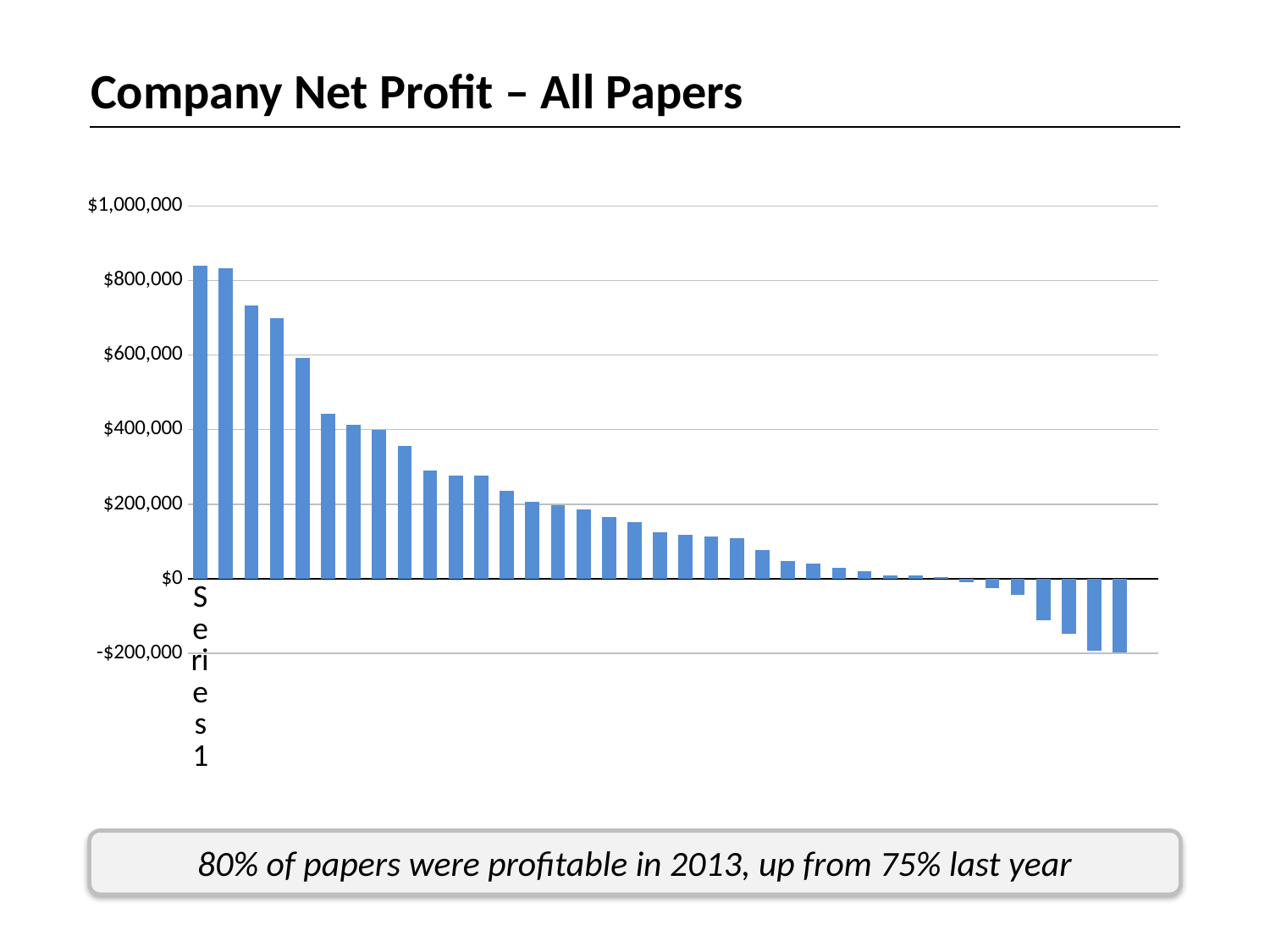
Do the bar values rise or fall from left to right across the chart? fall What kind of chart is shown on the slide? bar chart Is the value of the rightmost bar greater or less than $0? less Is the value of the third bar from the left greater or less than $600,000? greater Is the value of the leftmost bar greater or less than $800,000? greater Are any of the bars in the chart below $0? yes What is the title of the chart? Company Net Profit – All Papers What is the highest value shown on the vertical axis? $1,000,000 Which is taller, the third bar from the left or the tenth bar from the left? the third bar from the left